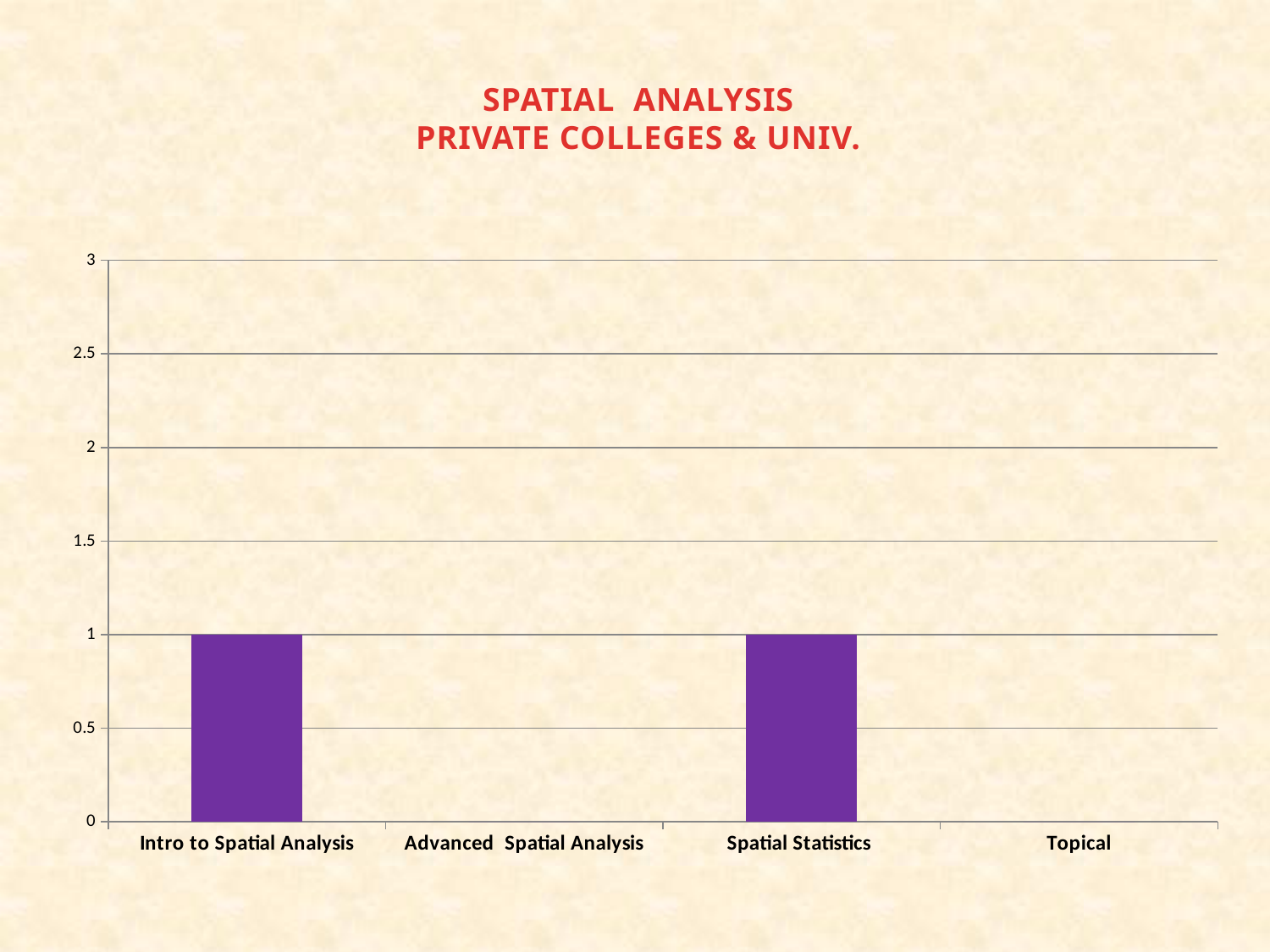
Is the value for Intro to Spatial Analysis greater or less than 2? less What is the title of the chart? SPATIAL ANALYSIS PRIVATE COLLEGES & UNIV. What kind of chart is shown on the slide? bar chart Which is larger, the value for Intro to Spatial Analysis or the value for Advanced Spatial Analysis? Intro to Spatial Analysis What is the value for Advanced Spatial Analysis? 0 What is the value for Topical? 0 What colour are the bars in the chart? purple What is the value for Intro to Spatial Analysis? 1 What is the value for Spatial Statistics? 1 Which is larger, the value for Spatial Statistics or the value for Topical? Spatial Statistics How many categories are shown on the x axis? 4 What is the difference between the value for Spatial Statistics and the value for Topical? 1